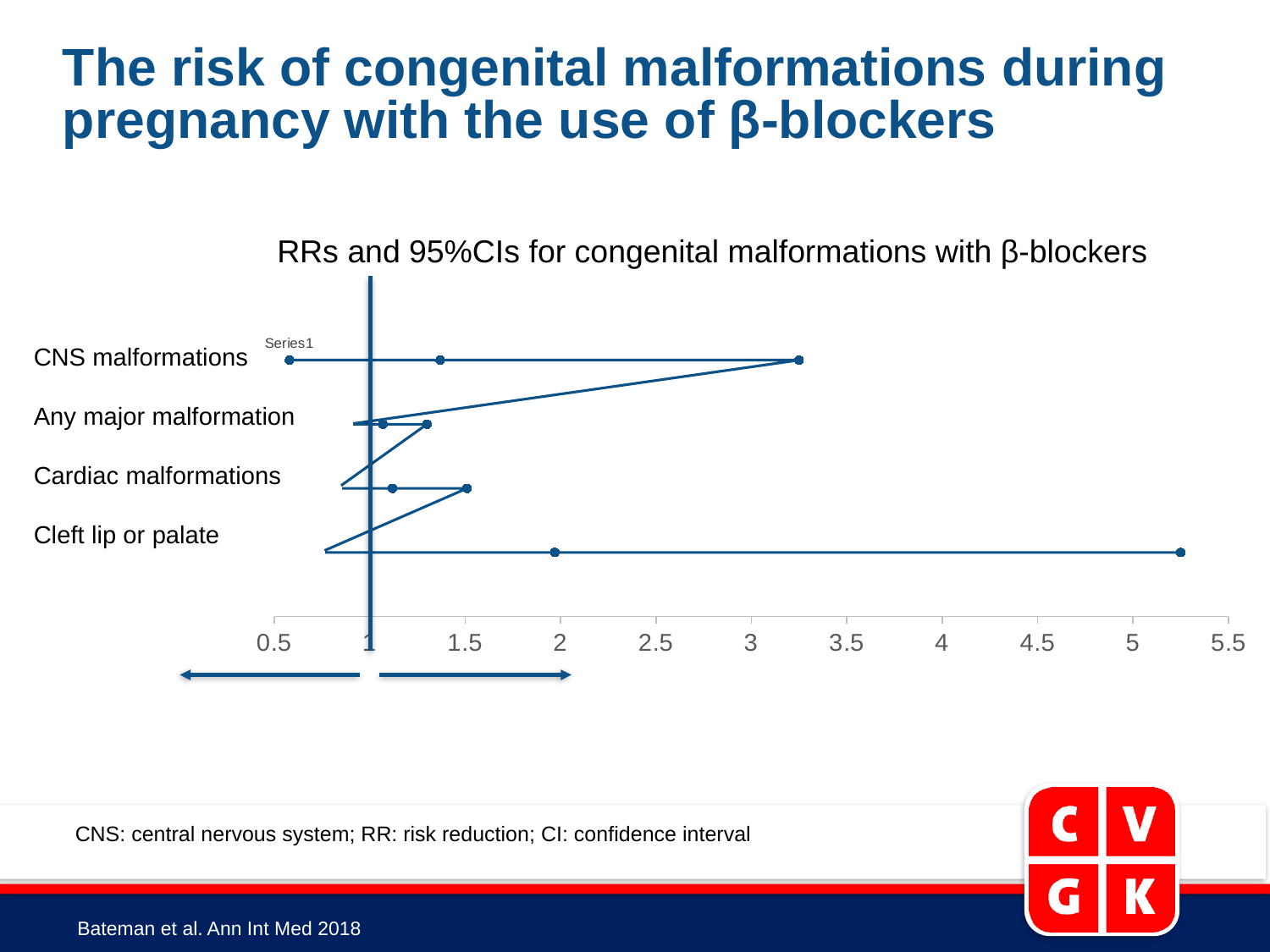
How many series does the chart legend list? 1 What kind of chart is shown on the slide? line chart Is the upper confidence limit for Cleft lip or palate greater or less than 5? greater Is the point estimate (RR) for Cleft lip or palate greater or less than 1.5? greater Is the lower confidence limit for CNS malformations greater or less than 1? less What is the title of the chart? RRs and 95%CIs for congenital malformations with β-blockers Which has the larger upper confidence limit: Cleft lip or palate or CNS malformations? Cleft lip or palate Which category has the lowest lower confidence limit on the chart? CNS malformations How many malformation categories are plotted on the chart? 4 At what x-axis value is the vertical reference line drawn on the chart? 1 Which category has the highest upper confidence limit on the chart? Cleft lip or palate